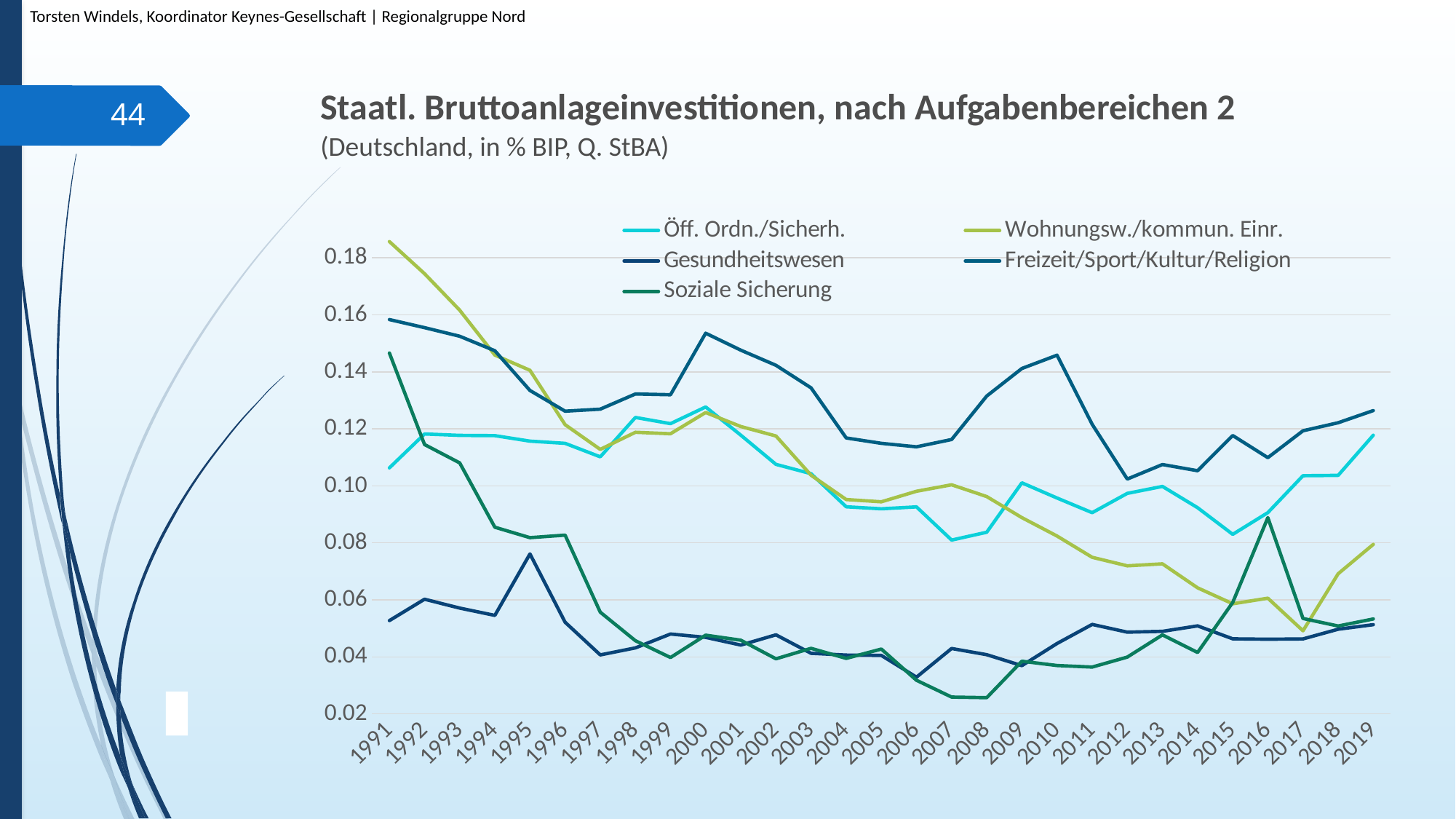
Is the value for Soziale Sicherung in 2008 greater or less than 0.04? less How many series does the legend list? 5 In 2019, which is larger: Öff. Ordn./Sicherh. or Gesundheitswesen? Öff. Ordn./Sicherh. Which series has the highest value in 1991? Wohnungsw./kommun. Einr. What is the title of the chart? Staatl. Bruttoanlageinvestitionen, nach Aufgabenbereichen 2 Is the value for Freizeit/Sport/Kultur/Religion in 2000 greater or less than 0.14? greater What kind of chart is shown on the slide? line chart How many years are shown on the x axis? 29 Which series has the highest value in 2010? Freizeit/Sport/Kultur/Religion Is the value for Wohnungsw./kommun. Einr. in 1991 greater or less than 0.16? greater Which series has the lowest value in 2008? Soziale Sicherung Does the Wohnungsw./kommun. Einr. series rise or fall from 1991 to 2015? fall